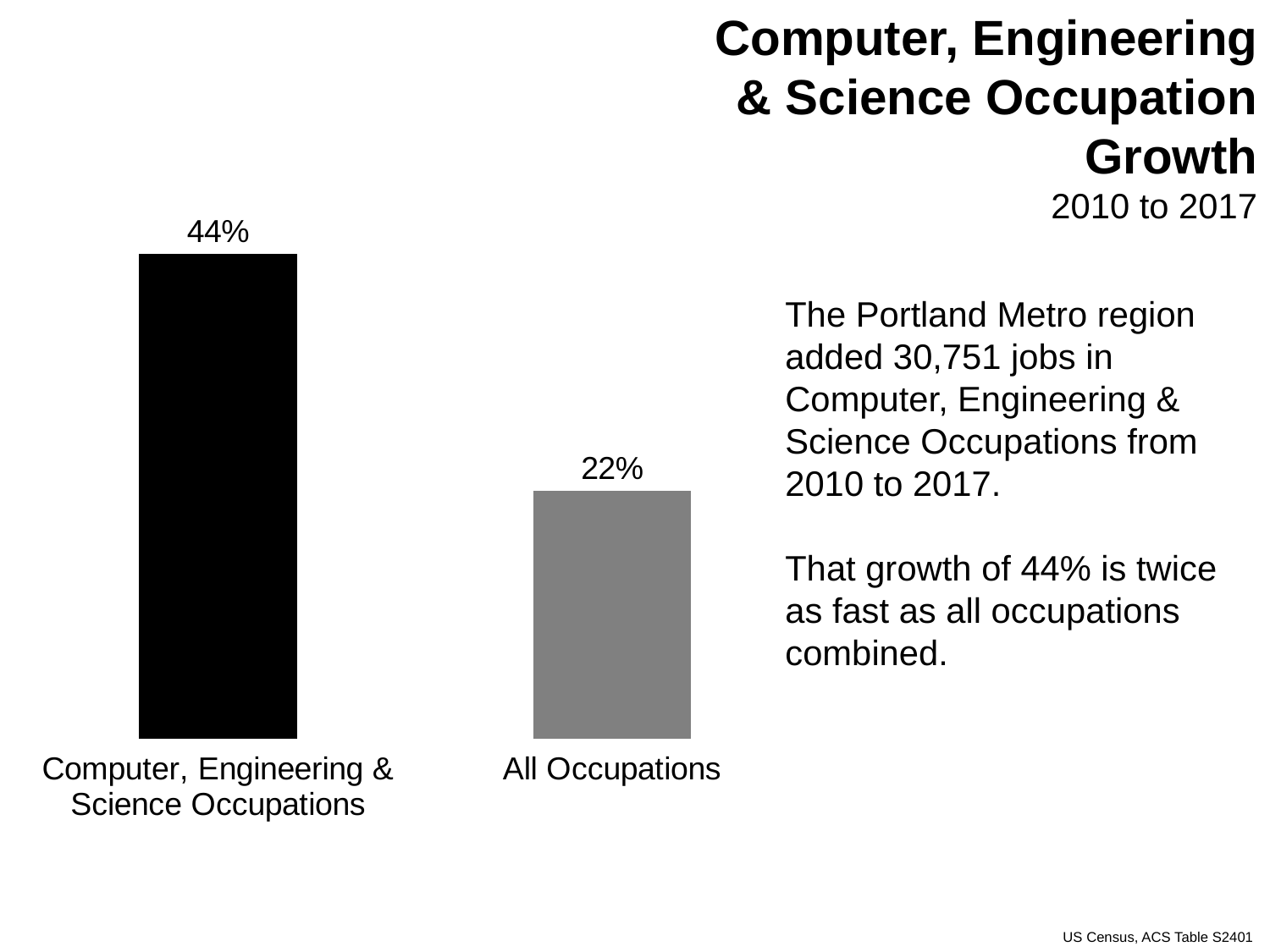
What is the growth value shown for All Occupations? 22% What is the difference between the values for Computer, Engineering & Science Occupations and All Occupations? 22% What time period does the chart cover, according to the subtitle? 2010 to 2017 How many categories are shown in the chart? 2 Which category has the highest value in the chart? Computer, Engineering & Science Occupations Which is larger: the value for Computer, Engineering & Science Occupations or the value for All Occupations? Computer, Engineering & Science Occupations What is the growth value shown for Computer, Engineering & Science Occupations? 44% What is the title of the chart? Computer, Engineering & Science Occupation Growth Which category has the lowest value in the chart? All Occupations What kind of chart is shown on the slide? Bar chart